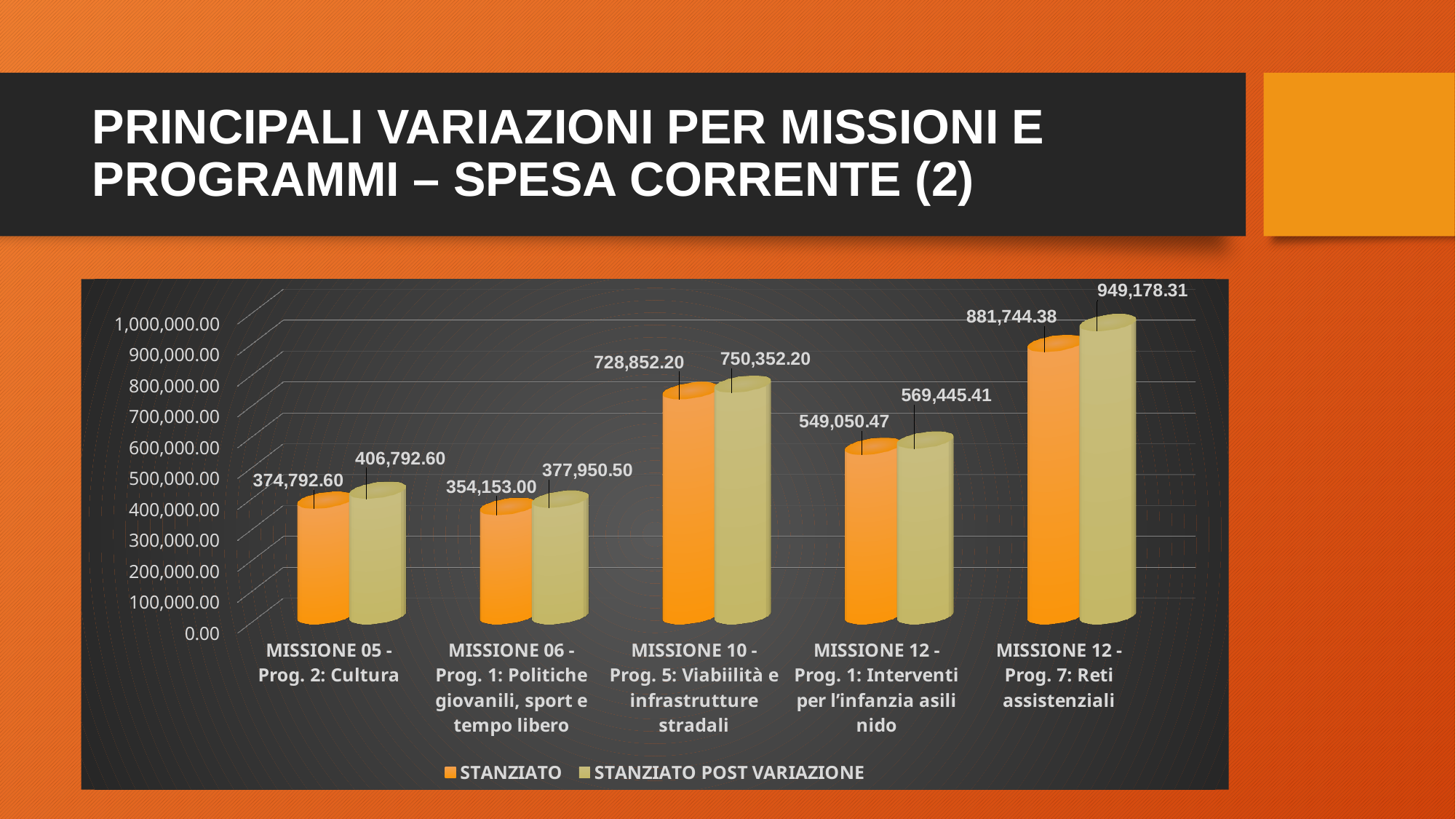
What is the difference between STANZIATO POST VARIAZIONE and STANZIATO for MISSIONE 12 - Prog. 7: Reti assistenziali? 67,433.93 What is the STANZIATO value for MISSIONE 05 - Prog. 2: Cultura? 374,792.60 What is the difference between STANZIATO POST VARIAZIONE and STANZIATO for MISSIONE 05 - Prog. 2: Cultura? 32,000.00 What is the STANZIATO value for MISSIONE 10 - Prog. 5: Viabiilità e infrastrutture stradali? 728,852.20 How many series does the legend list? 2 Which category has the highest STANZIATO POST VARIAZIONE value? MISSIONE 12 - Prog. 7: Reti assistenziali What is the STANZIATO POST VARIAZIONE value for MISSIONE 06 - Prog. 1: Politiche giovanili, sport e tempo libero? 377,950.50 What kind of chart is shown on the slide? Bar chart Which is larger: the STANZIATO value for MISSIONE 10 - Prog. 5 or the STANZIATO POST VARIAZIONE value for MISSIONE 12 - Prog. 1? STANZIATO for MISSIONE 10 - Prog. 5 Which category has the lowest STANZIATO value? MISSIONE 06 - Prog. 1: Politiche giovanili, sport e tempo libero How many categories are shown on the x axis? 5 What is the STANZIATO POST VARIAZIONE value for MISSIONE 12 - Prog. 7: Reti assistenziali? 949,178.31